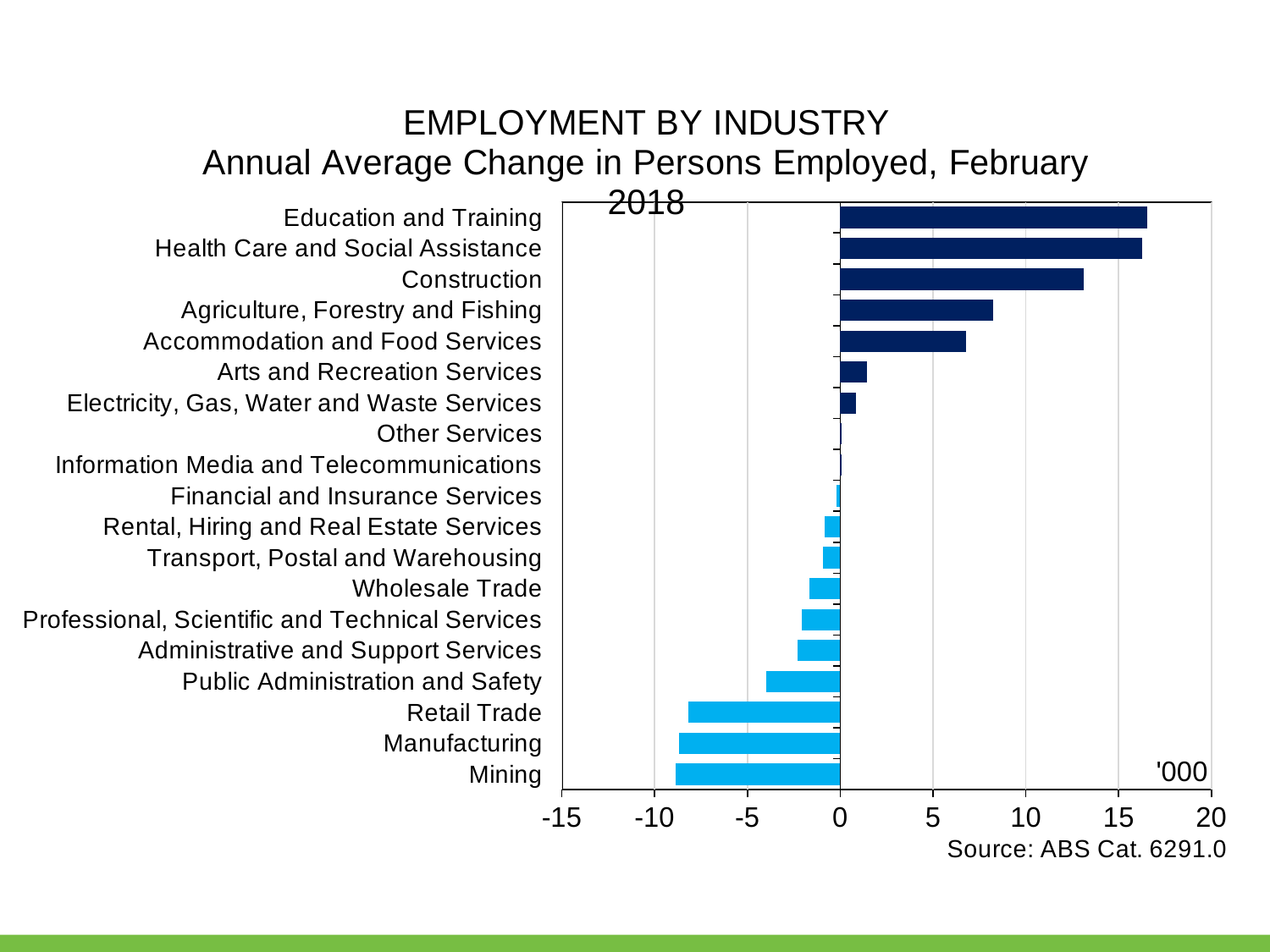
Is the value for Public Administration and Safety greater or less than -5? greater What unit is shown on the horizontal axis of the chart? '000 Is the value for Accommodation and Food Services greater or less than 10? less Is the value for Agriculture, Forestry and Fishing greater or less than 5? greater What source is cited for the chart? ABS Cat. 6291.0 How many industries are plotted in the chart? 19 What kind of chart is shown on the slide? bar chart Which has the larger value, Construction or Agriculture, Forestry and Fishing? Construction Which has the larger value, Arts and Recreation Services or Accommodation and Food Services? Accommodation and Food Services